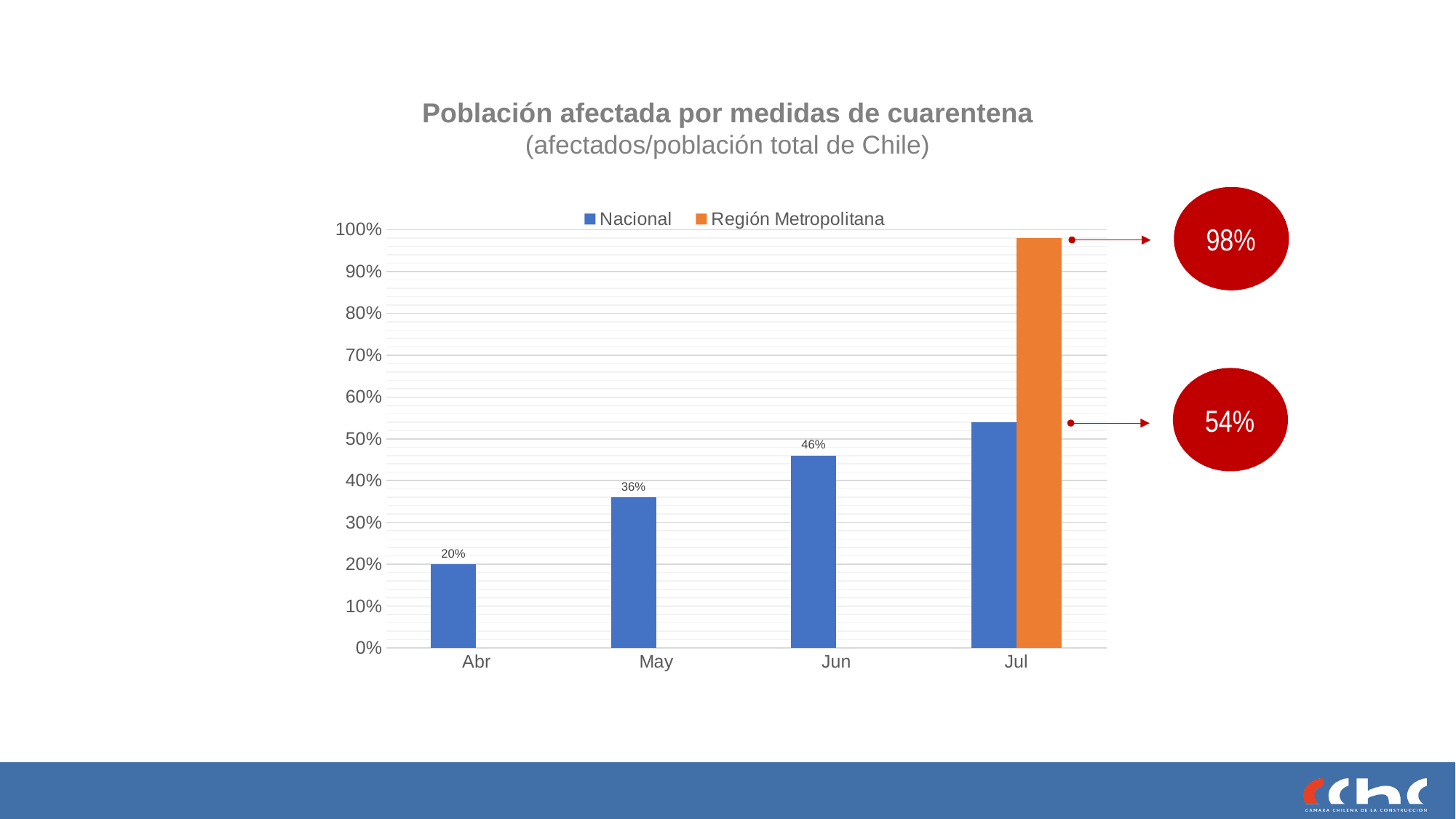
How many months are shown on the x axis? 4 What is the Nacional value for Jun? 46% What kind of chart is shown on the slide? Bar chart What is the Región Metropolitana value for Jul? 98% Do the Nacional values rise or fall from Abr to Jul? Rise In which month is the Nacional value highest? Jul What is the Nacional value for Jul? 54% What is the difference between the Región Metropolitana and Nacional values for Jul? 44 percentage points In which month is the Nacional value lowest? Abr How many series does the legend list? 2 What is the Nacional value for Abr? 20% What is the Nacional value for May? 36%